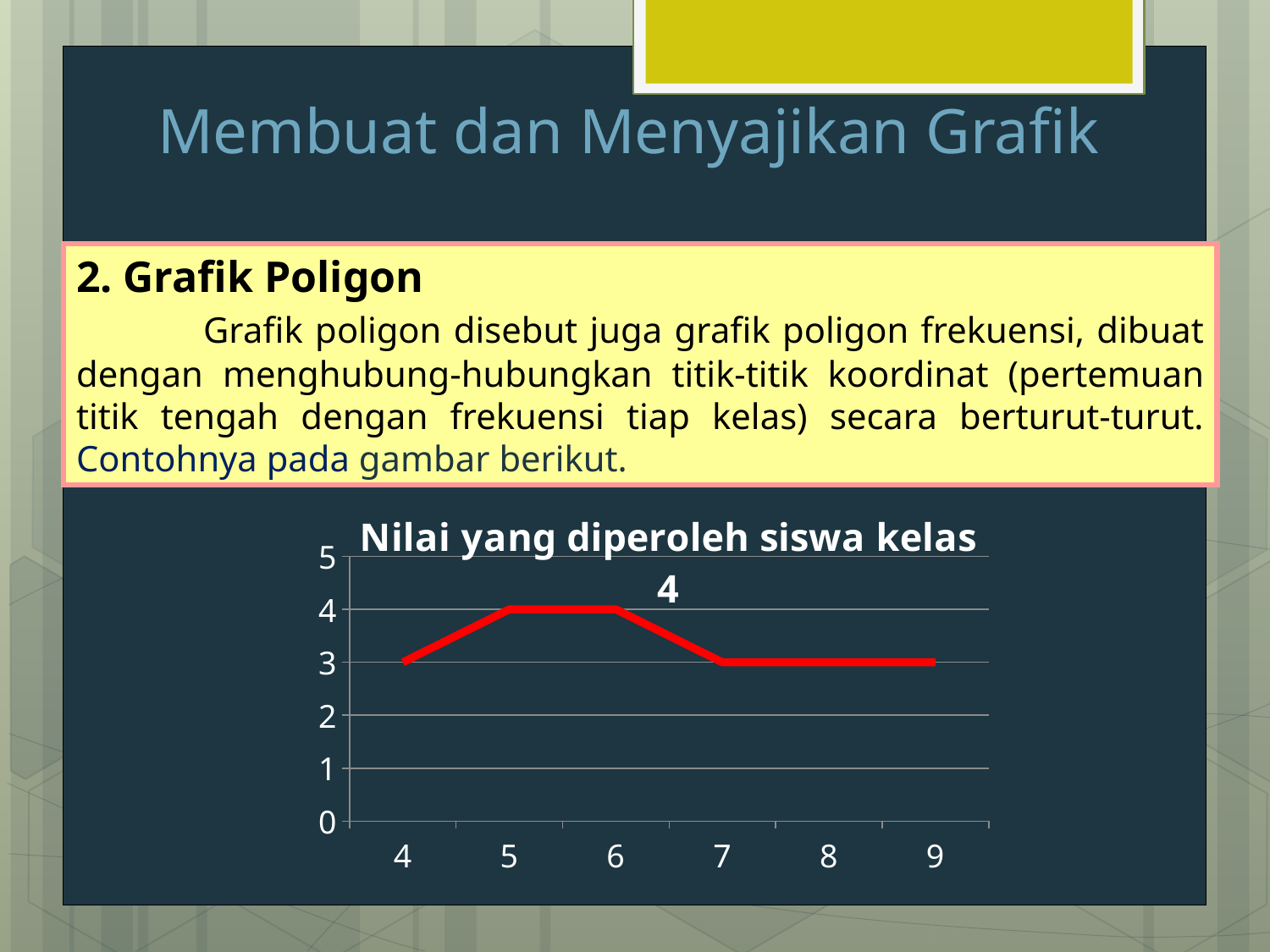
Which is larger, the value at x = 5 or the value at x = 9? x = 5 What kind of chart is shown on the slide? line chart How many points are plotted on the x axis? 6 What is the difference between the value at x = 6 and the value at x = 7? 1 What is the title of the chart? Nilai yang diperoleh siswa kelas 4 Does the line rise or fall between x = 4 and x = 5? rise What colour is the line in the chart? red What is the value at x = 4? 3 What is the highest value reached by the line? 4 What is the value at x = 5? 4 What is the value at x = 8? 3 What is the lowest value reached by the line? 3